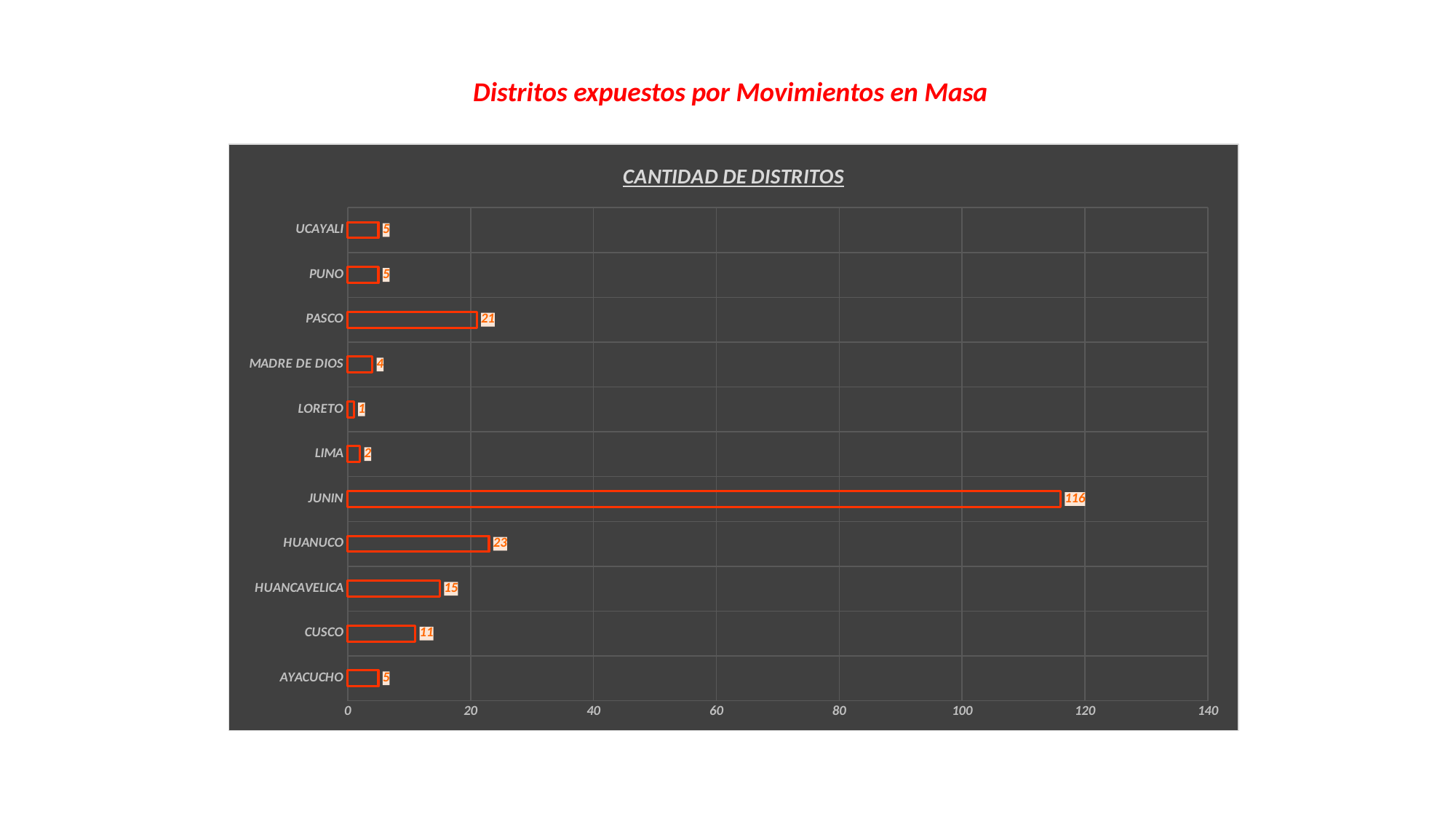
Which is larger, the value for HUANCAVELICA or the value for CUSCO? HUANCAVELICA Which category has the lowest value? LORETO What is the difference between the values for JUNIN and HUANUCO? 93 Which category has the highest value? JUNIN Is the value for JUNIN greater or less than 100? greater What is the value for MADRE DE DIOS? 4 What is the title shown inside the chart area? CANTIDAD DE DISTRITOS What is the value for JUNIN? 116 What is the value for HUANUCO? 23 What is the value for PASCO? 21 What kind of chart is shown on the slide? bar chart How many categories are shown on the chart? 11